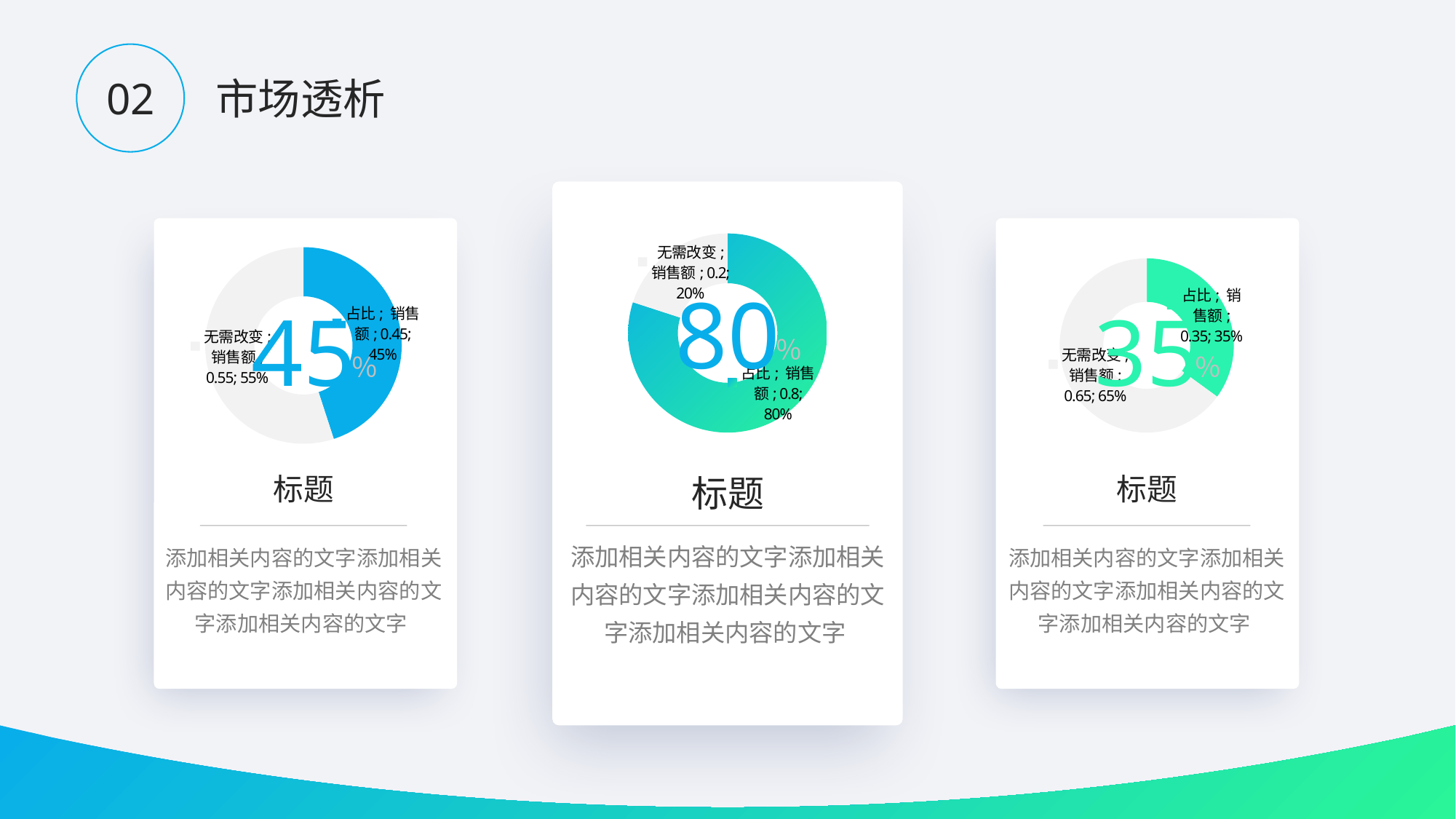
In the right chart, which slice is the smallest? 占比 In the right chart, what percentage is shown for the 无需改变 slice? 65% In the left chart, which slice is larger, 占比 or 无需改变? 无需改变 In the right chart, what value is shown for the 占比 slice? 0.35 In the middle chart, which slice is the largest? 占比 In the left chart, what percentage is shown for the 占比 slice? 45% In the left chart, what value is shown for the 无需改变 slice? 0.55 What kind of chart is the middle chart? Doughnut (pie) chart How many slices does the left chart have? 2 In the middle chart, what is the difference in percentage points between the 占比 slice and the 无需改变 slice? 60 In the middle chart, what value is shown for the 无需改变 slice? 0.2 In the middle chart, what percentage is shown for the 占比 slice? 80%